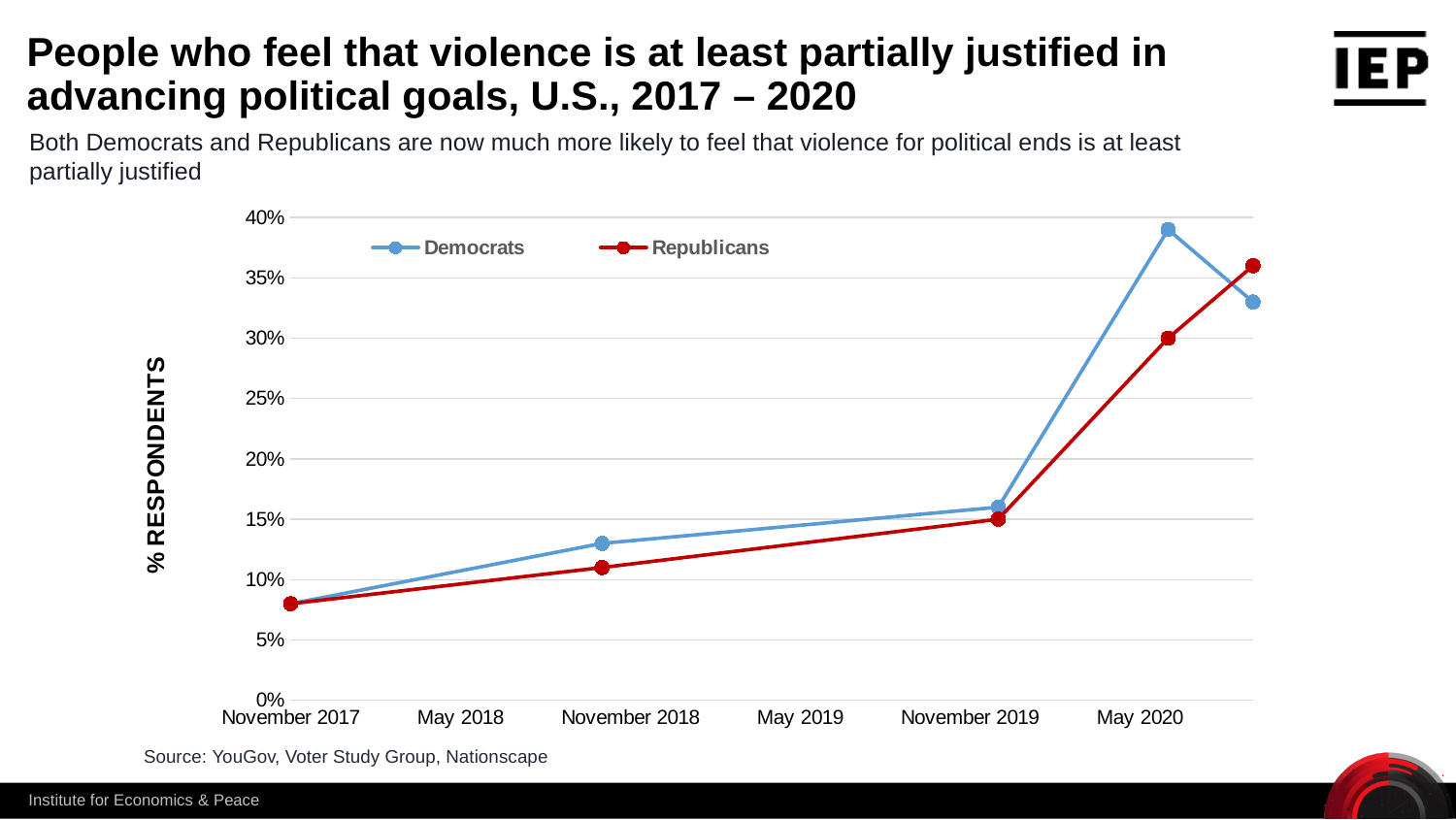
Is the value for Republicans in May 2020 greater or less than 25%? greater Is the value for Democrats in May 2020 greater or less than 35%? greater Is the value for Republicans in November 2018 greater or less than 10%? greater Which two series are shown in the legend? Democrats and Republicans What is the label of the y axis? % RESPONDENTS How many series does the legend list? 2 Does the Republicans line rise or fall from November 2017 to May 2020? rise In May 2020, which series has the higher value, Democrats or Republicans? Democrats What kind of chart is shown on the slide? line chart At which labelled date does the Democrats line reach its highest value? May 2020